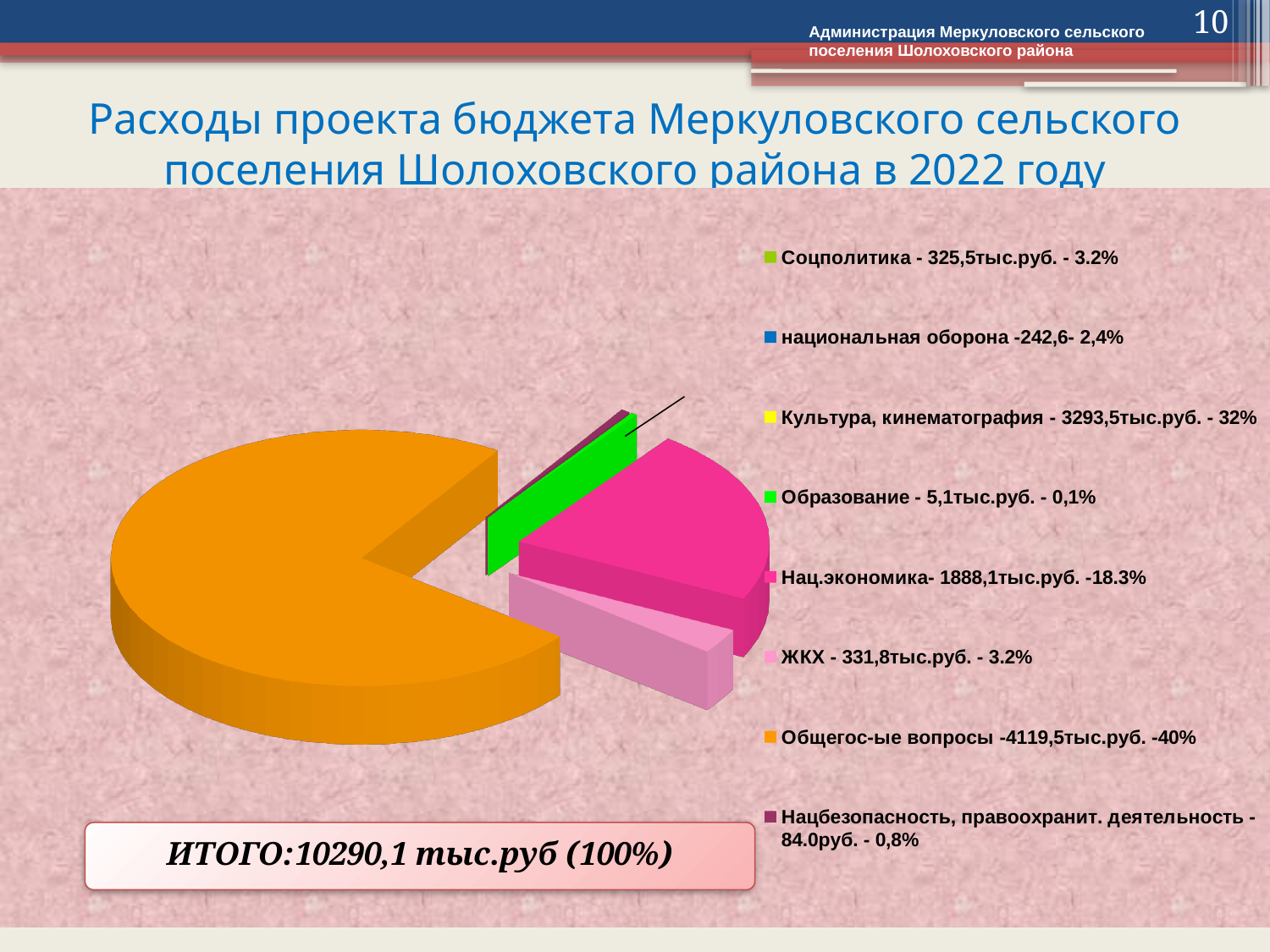
Which category has the smallest share of the budget expenses? Образование What is the total of the budget expenses shown on the slide? 10290,1 тыс.руб How many categories does the legend of the pie chart list? 8 Which is larger, the amount for Соцполитика or for национальная оборона? Соцполитика What percentage share is shown for Нац.экономика? 18.3% What percentage share is shown for Общегос-ые вопросы? 40% What is the difference between the amounts for Общегос-ые вопросы and Культура, кинематография (in тыс.руб.)? 826,0 What kind of chart is shown on the slide? pie chart What percentage share is shown for Нацбезопасность, правоохранит. деятельность? 0,8% What amount is shown for Культура, кинематография? 3293,5тыс.руб. What amount is shown for ЖКХ? 331,8тыс.руб. Which category has the largest share of the budget expenses? Общегос-ые вопросы